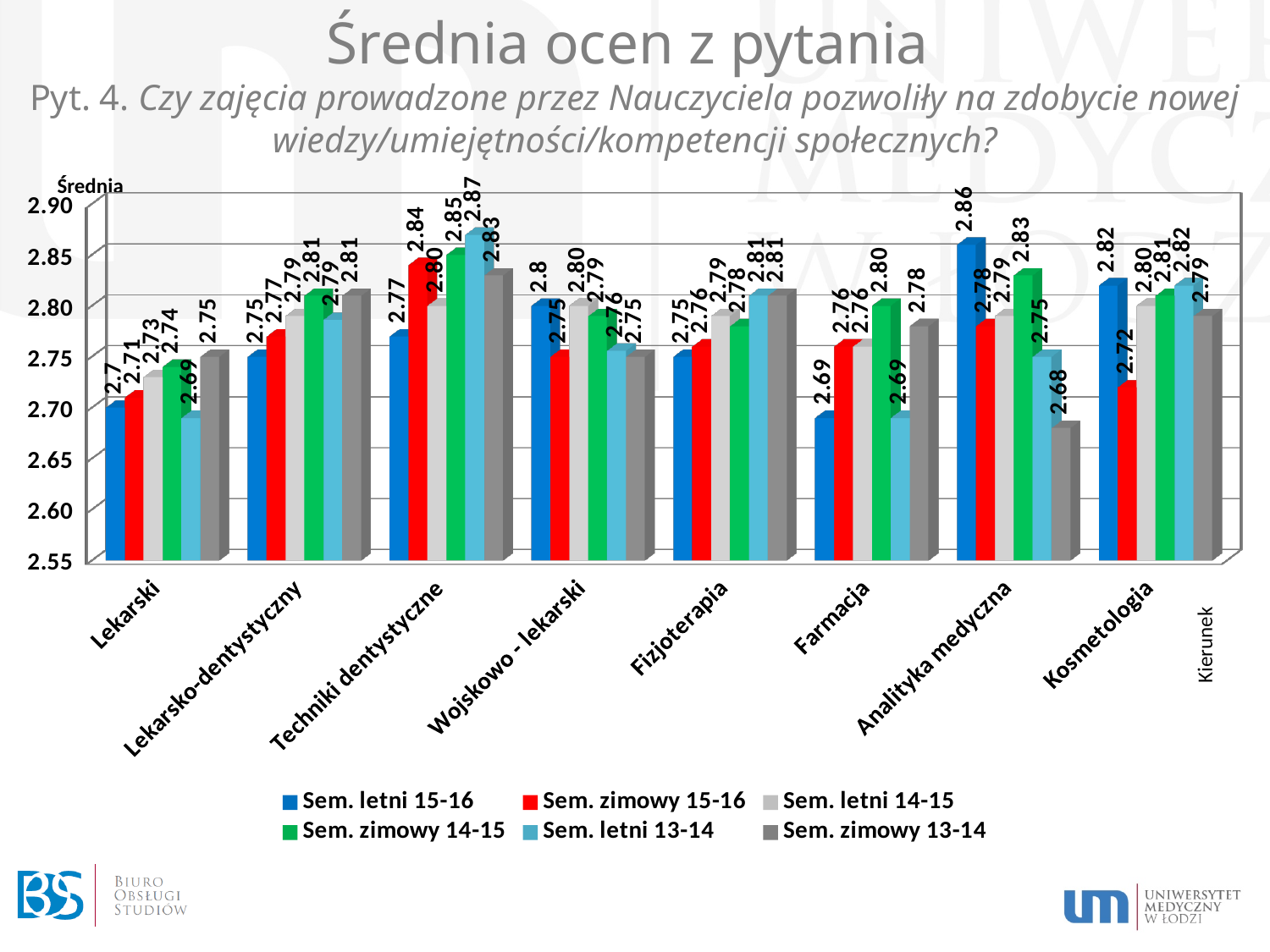
Which category has the lowest value in the Sem. zimowy 13-14 series? Analityka medyczna What kind of chart is shown on the slide? Bar chart What is the value for Techniki dentystyczne in the Sem. letni 13-14 series? 2.87 What is the difference between the Sem. letni 15-16 value and the Sem. zimowy 13-14 value for Analityka medyczna? 0.18 For Lekarski, which is larger: the Sem. zimowy 13-14 value or the Sem. letni 13-14 value? Sem. zimowy 13-14 What is the value for Farmacja in the Sem. zimowy 14-15 series? 2.80 What is the value for Kosmetologia in the Sem. zimowy 15-16 series? 2.72 How many series does the legend list? 6 Which category has the highest value in the Sem. letni 15-16 series? Analityka medyczna What is the value for Analityka medyczna in the Sem. letni 15-16 series? 2.86 What is the label of the vertical axis? Średnia How many categories (kierunki) are shown on the x axis? 8